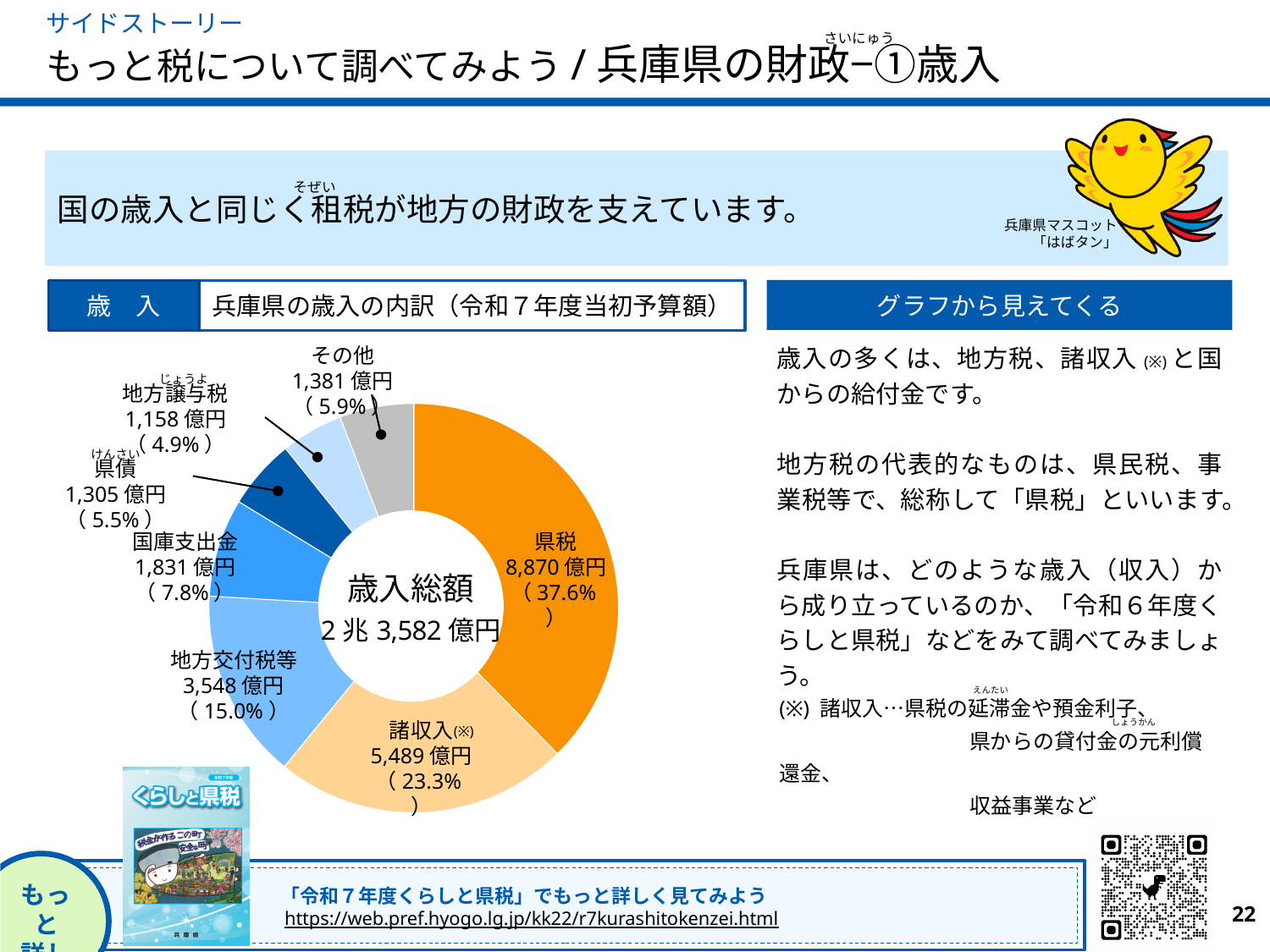
県税の金額はいくらですか。 8,870 億円 グラフに示されている歳入の項目はいくつありますか。 7 国庫支出金と県債では、どちらの金額が大きいですか。 国庫支出金 県税と諸収入の金額の差はいくらですか。 3,381 億円 歳入の項目の中で最も金額が大きいのはどれですか。 県税 このグラフはどの種類のグラフですか。 円グラフ（ドーナツグラフ） グラフのタイトルは何ですか。 兵庫県の歳入の内訳（令和７年度当初予算額） 地方交付税等の金額はいくらですか。 3,548 億円 諸収入の割合は何％ですか。 23.3% グラフの中央に示されている歳入総額はいくらですか。 2 兆 3,582 億円 歳入の項目の中で最も金額が小さいのはどれですか。 地方譲与税 その他の割合は何％ですか。 5.9%